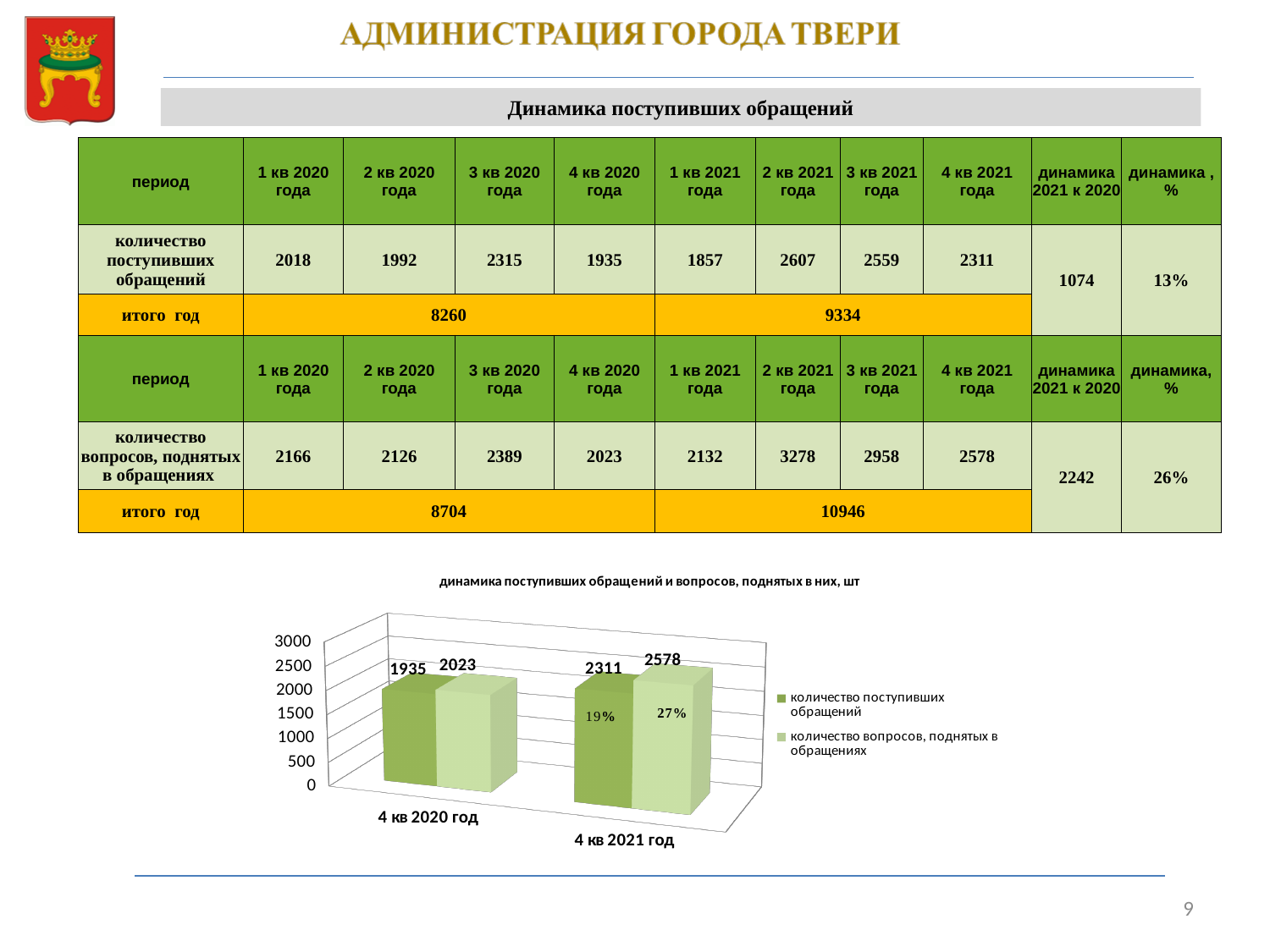
How many categories are shown on the x axis of the chart? 2 What is the value for "количество поступивших обращений" in 4 кв 2021 год? 2311 What is the title of the chart? динамика поступивших обращений и вопросов, поднятых в них, шт What type of chart is shown on the slide? bar chart Does the value for "количество поступивших обращений" rise or fall from 4 кв 2020 год to 4 кв 2021 год? rise What is the difference between "количество вопросов, поднятых в обращениях" in 4 кв 2021 год and in 4 кв 2020 год? 555 What is the value for "количество поступивших обращений" in 4 кв 2020 год? 1935 Which is larger: "количество поступивших обращений" in 4 кв 2020 год or in 4 кв 2021 год? 4 кв 2021 год What is the value for "количество вопросов, поднятых в обращениях" in 4 кв 2021 год? 2578 How many series does the chart legend list? 2 What is the value for "количество вопросов, поднятых в обращениях" in 4 кв 2020 год? 2023 What is the difference between "количество поступивших обращений" in 4 кв 2021 год and in 4 кв 2020 год? 376